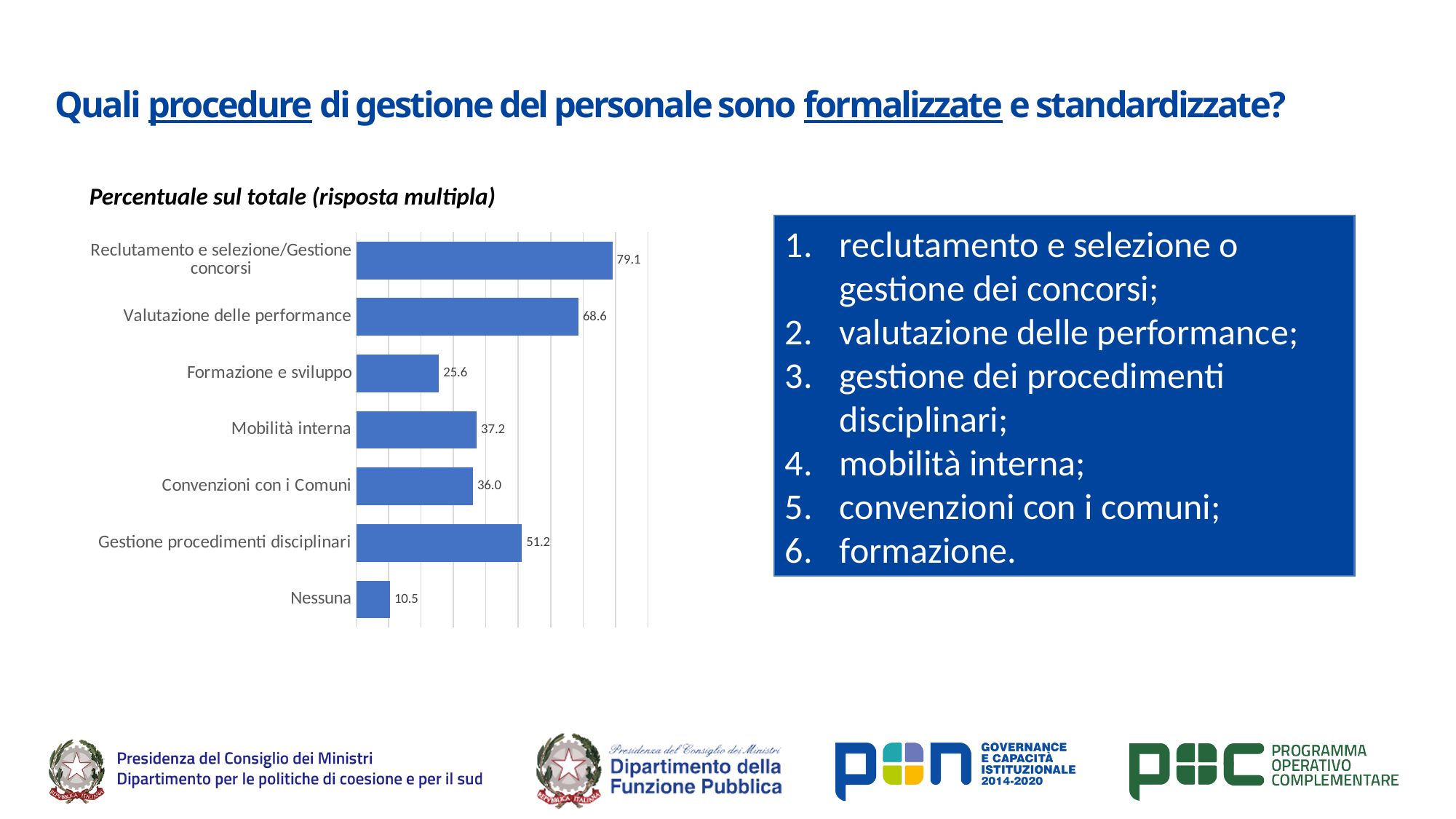
What is the difference between the values for Reclutamento e selezione/Gestione concorsi and Valutazione delle performance? 10.5 What is the difference between the values for Mobilità interna and Convenzioni con i Comuni? 1.2 How many categories are shown in the chart? 7 What kind of chart is shown on the slide? Bar chart Which is larger, the value for Gestione procedimenti disciplinari or the value for Mobilità interna? Gestione procedimenti disciplinari What is the value for Formazione e sviluppo? 25.6 What is the title of the chart? Percentuale sul totale (risposta multipla) What is the value for Valutazione delle performance? 68.6 Which category has the highest value? Reclutamento e selezione/Gestione concorsi Which category has the lowest value? Nessuna What is the value for Nessuna? 10.5 What is the value for Reclutamento e selezione/Gestione concorsi? 79.1